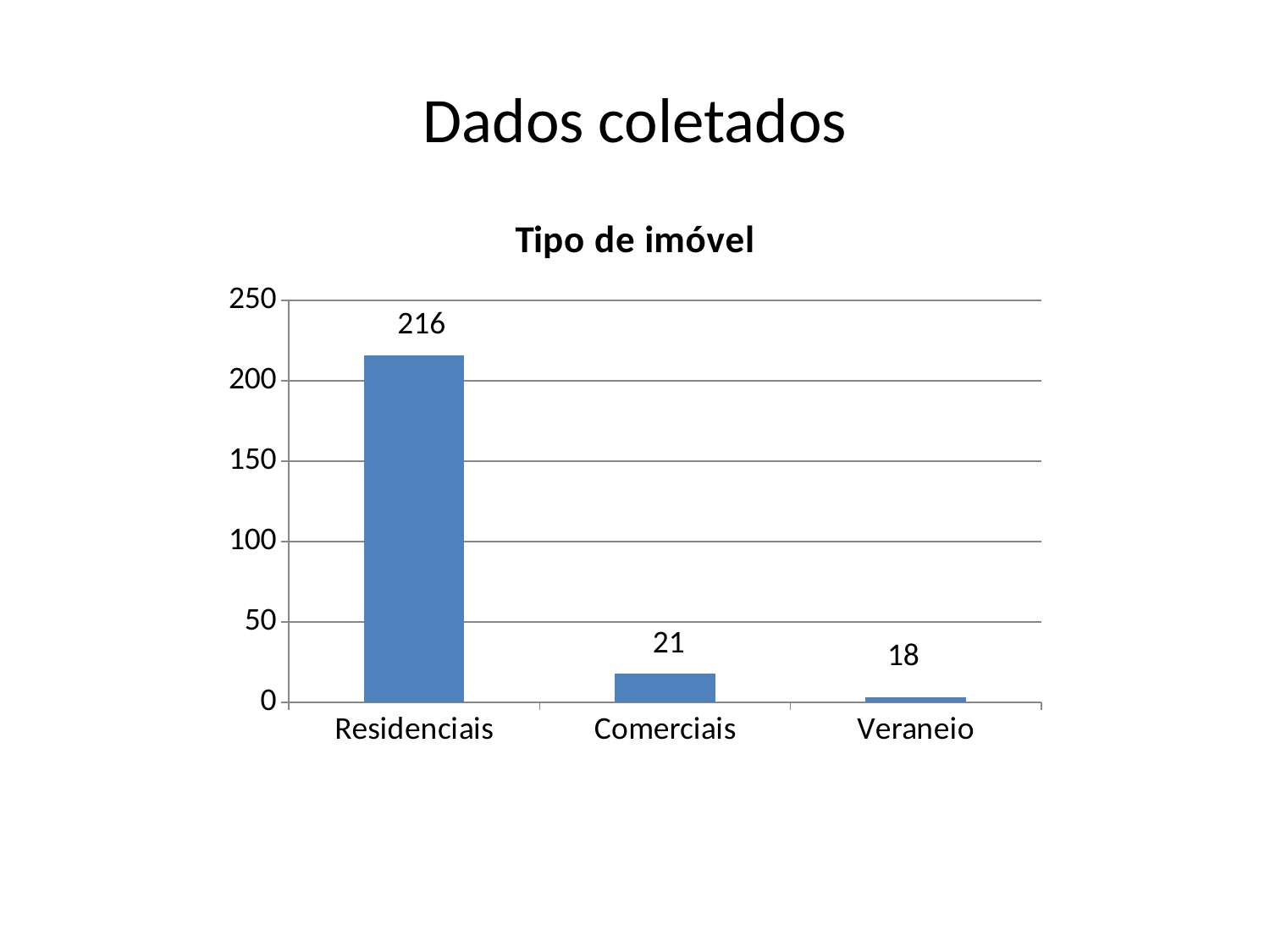
What is the value for Residenciais? 216 What is the title of the chart? Tipo de imóvel What is the value for Comerciais? 21 What is the difference between the values for Comerciais and Veraneio? 3 What is the difference between the values for Residenciais and Comerciais? 195 What is the value for Veraneio? 18 Is the value for Residenciais greater or less than 200? greater Which category has the lowest value? Veraneio Which category has the highest value? Residenciais How many categories are shown on the x axis? 3 What kind of chart is shown on the slide? bar chart Which is larger, the value for Residenciais or the value for Veraneio? Residenciais